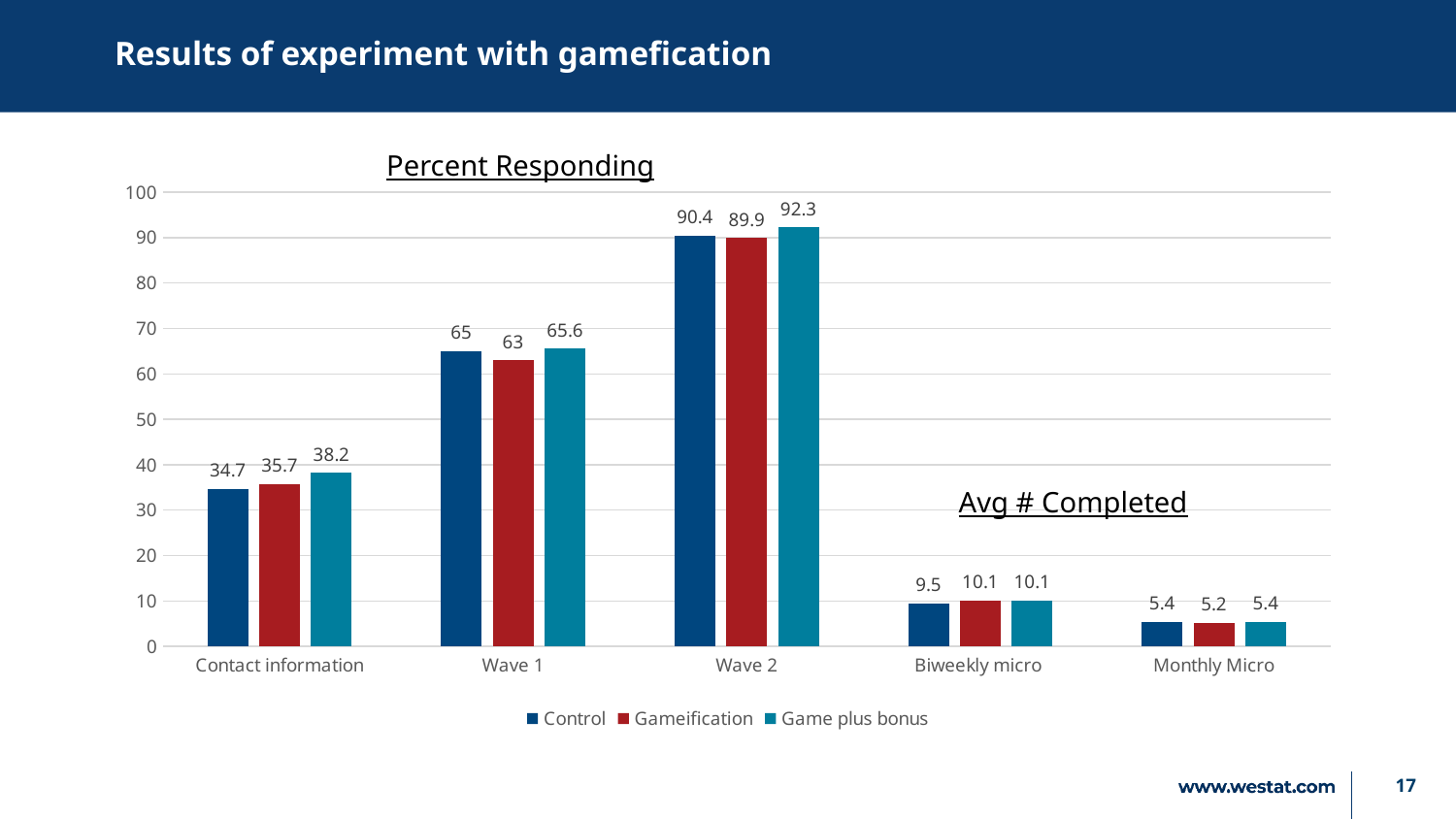
How many series does the legend list? 3 What is the value for Control in the Contact information category? 34.7 What is the difference between the Game plus bonus and Control values in the Contact information category? 3.5 What are the three series listed in the legend? Control, Gameification, Game plus bonus What is the value for Gameification in the Wave 1 category? 63 In the Wave 1 category, which is larger: the Control value or the Gameification value? Control What is the value for Gameification in the Biweekly micro category? 10.1 What is the value for Game plus bonus in the Wave 2 category? 92.3 Which category has the highest value for the Control series? Wave 2 What kind of chart is shown on the slide? Bar chart Which category has the lowest value for the Game plus bonus series? Monthly Micro How many categories are shown on the x axis? 5